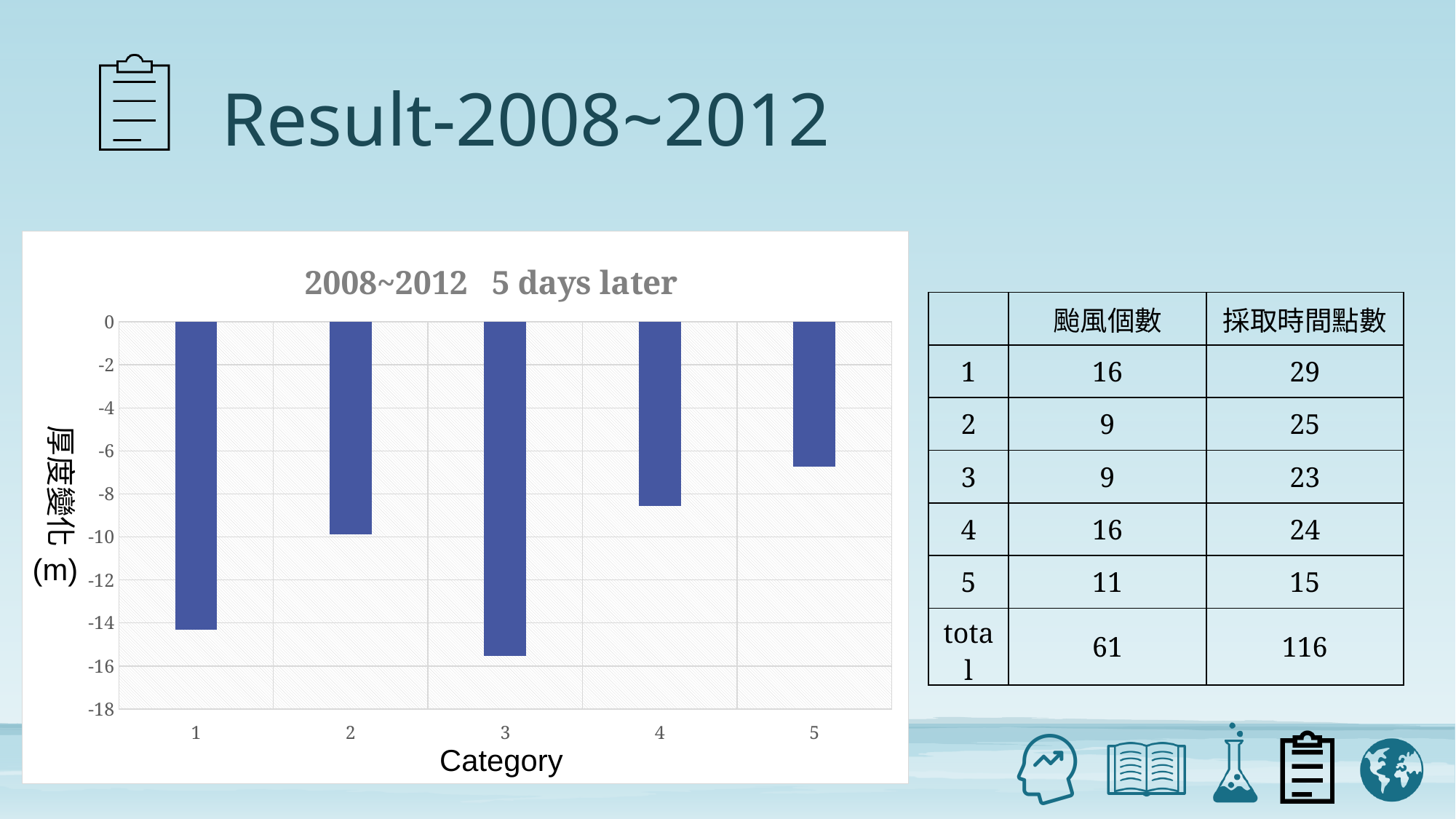
Which category has the lowest (most negative) value in the chart? 3 Is the value for category 1 greater or less than -12? less Is the value for category 5 greater or less than -8? greater Which category has the highest (least negative) value in the chart? 5 What is the label of the x axis of the chart? Category Is the value for category 4 greater or less than -10? greater How many categories are plotted in the chart? 5 Which bar extends further below zero, category 1 or category 2? 1 What kind of chart is shown on the slide? bar chart What is the title of the chart? 2008~2012 5 days later